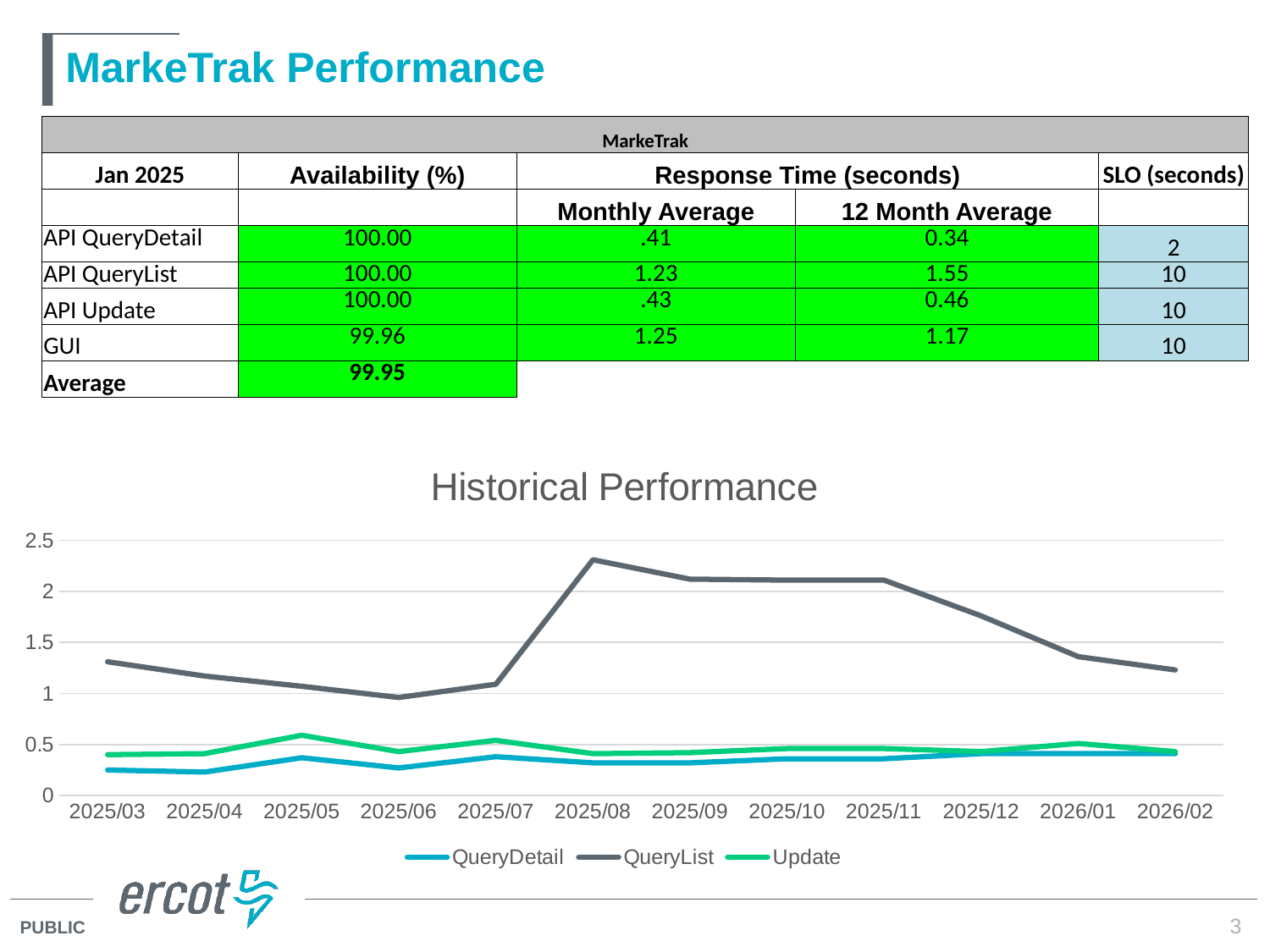
In the Historical Performance chart, is the QueryDetail value for 2025/03 greater or less than 0.5? less Which series in the Historical Performance chart has the lowest value in 2025/03? QueryDetail What are the legend entries of the Historical Performance chart? QueryDetail, QueryList, Update In the Historical Performance chart, which is larger in 2025/05: the Update value or the QueryDetail value? Update Which series in the Historical Performance chart has the highest value in 2025/08? QueryList In the Historical Performance chart, does the QueryList series rise or fall from 2025/08 to 2026/02? fall How many series does the legend of the Historical Performance chart list? 3 In the Historical Performance chart, is the QueryList value for 2025/06 greater or less than 1.5? less What kind of chart is the Historical Performance chart? line chart What is the title of the line chart on the slide? Historical Performance In the Historical Performance chart, is the QueryList value for 2025/08 greater or less than 2? greater How many months are shown on the x axis of the Historical Performance chart? 12